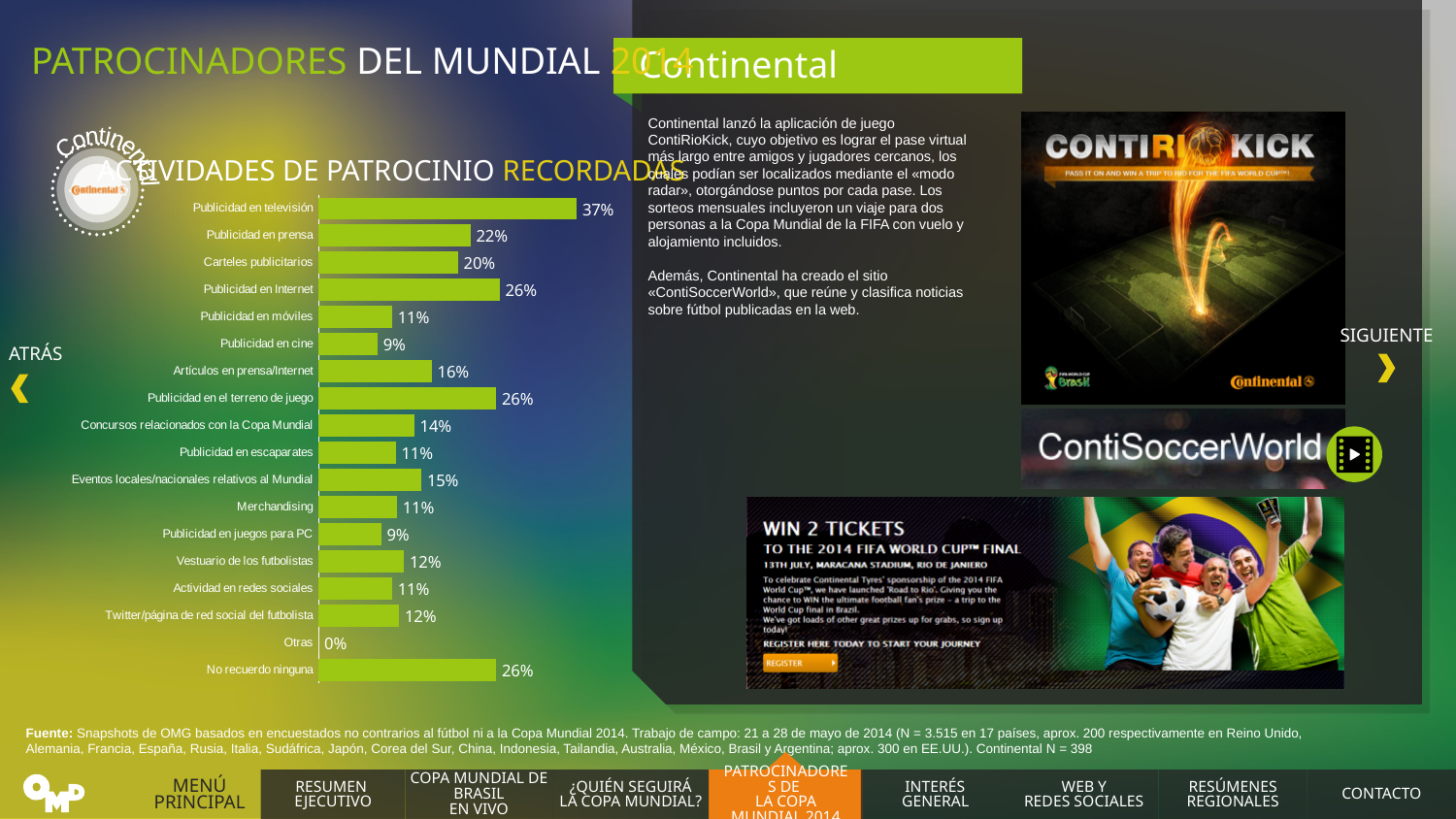
Which category has the lowest value in the chart? Otras Which is larger, Publicidad en Internet or Publicidad en móviles? Publicidad en Internet What value is shown for No recuerdo ninguna? 26% What is the difference between Publicidad en televisión and Publicidad en prensa? 15% Which is larger, Eventos locales/nacionales relativos al Mundial or Vestuario de los futbolistas? Eventos locales/nacionales relativos al Mundial What type of chart is shown on the slide? Bar chart How many categories are shown in the chart? 18 Which category has the highest value in the chart? Publicidad en televisión What value is shown for Publicidad en televisión? 37% What value is shown for Concursos relacionados con la Copa Mundial? 14% What value is shown for Artículos en prensa/Internet? 16% What is the difference between Carteles publicitarios and Publicidad en cine? 11%